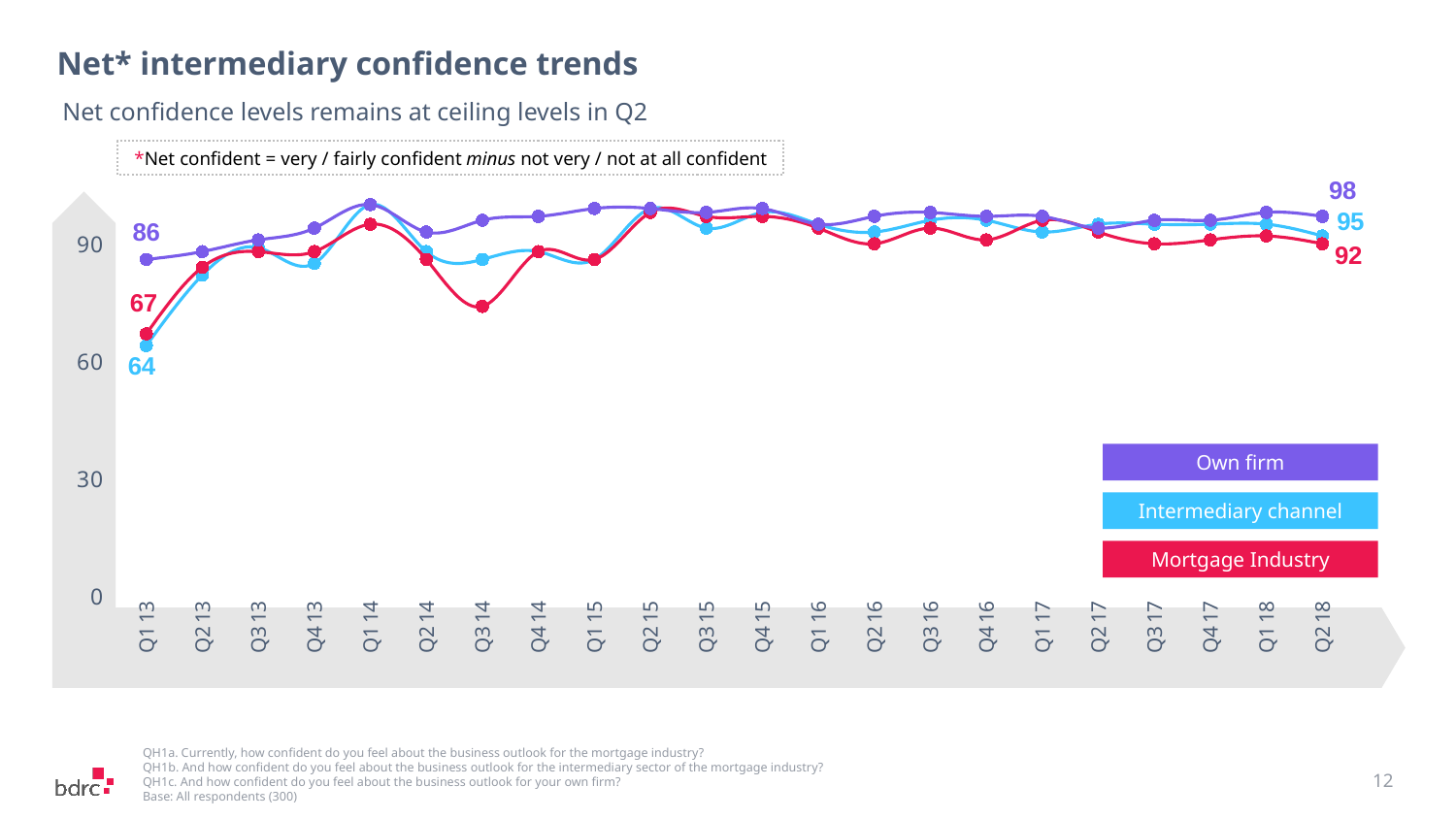
Which series is shown in red? Mortgage Industry Which series has the lowest value in Q1 13? Intermediary channel How many quarters are plotted along the x axis? 22 What is the value for Mortgage Industry in Q2 18? 92 What is the difference between the Own firm value in Q2 18 and in Q1 13? 12 What is the value for Mortgage Industry in Q1 13? 67 Which series has the highest value in Q2 18? Own firm What is the value for Own firm in Q1 13? 86 What kind of chart is shown on the slide? line chart Is the value for Mortgage Industry in Q3 14 greater or less than 90? less How many series does the legend list? 3 What is the value for Intermediary channel in Q2 18? 95